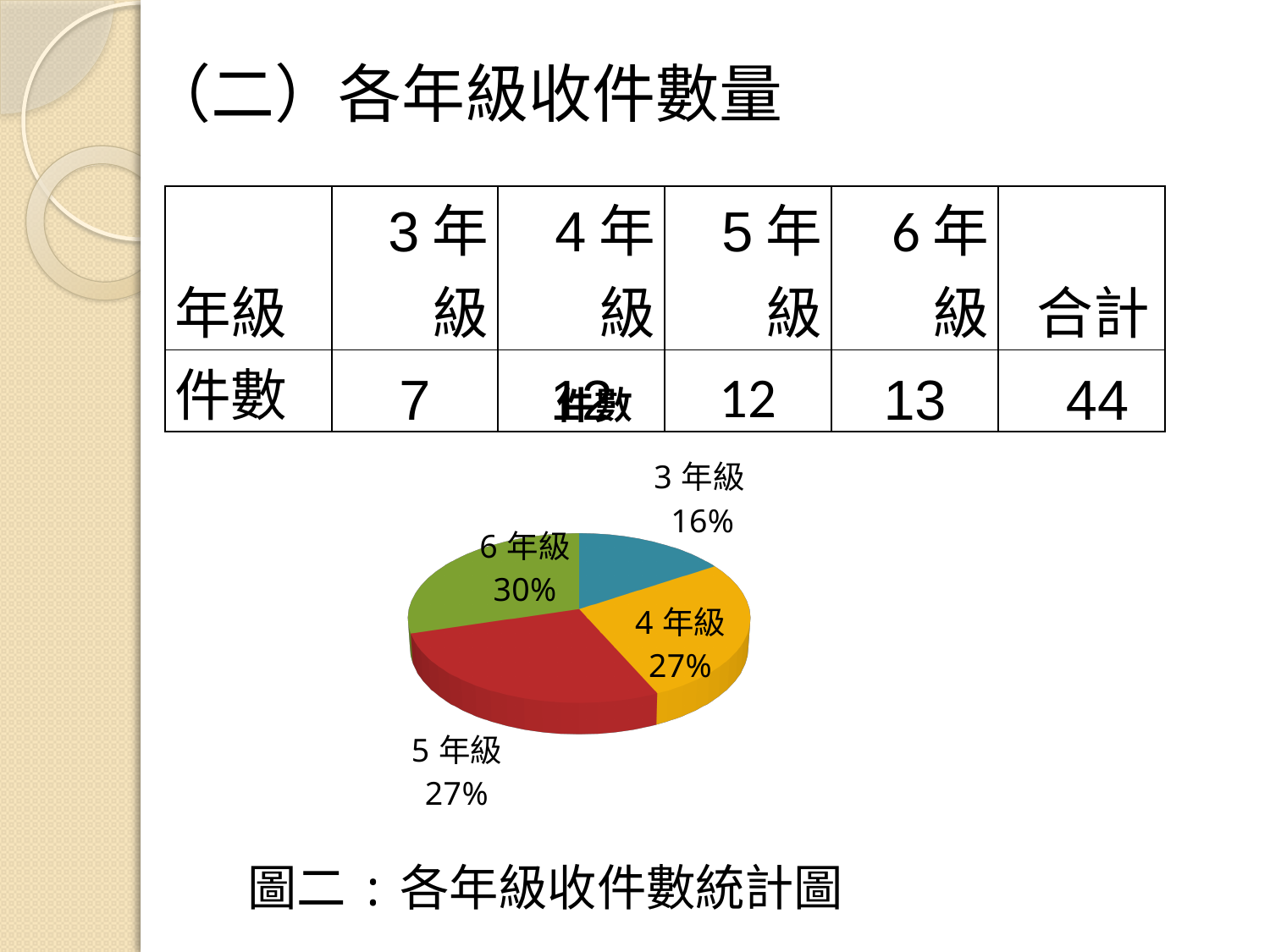
What kind of chart is shown on the slide? pie chart Which grade has the largest slice of the pie? 6 年級 What is the caption printed below the pie chart? 圖二：各年級收件數統計圖 What share of the pie does 6 年級 have? 30% Which slice is larger, 6 年級 or 3 年級? 6 年級 Which grade has the smallest slice of the pie? 3 年級 What share of the pie does 4 年級 have? 27% What share of the pie does 3 年級 have? 16% What is the difference in percentage points between the 6 年級 slice and the 3 年級 slice? 14% What colour is the 5 年級 slice of the pie? red How many slices does the pie chart have? 4